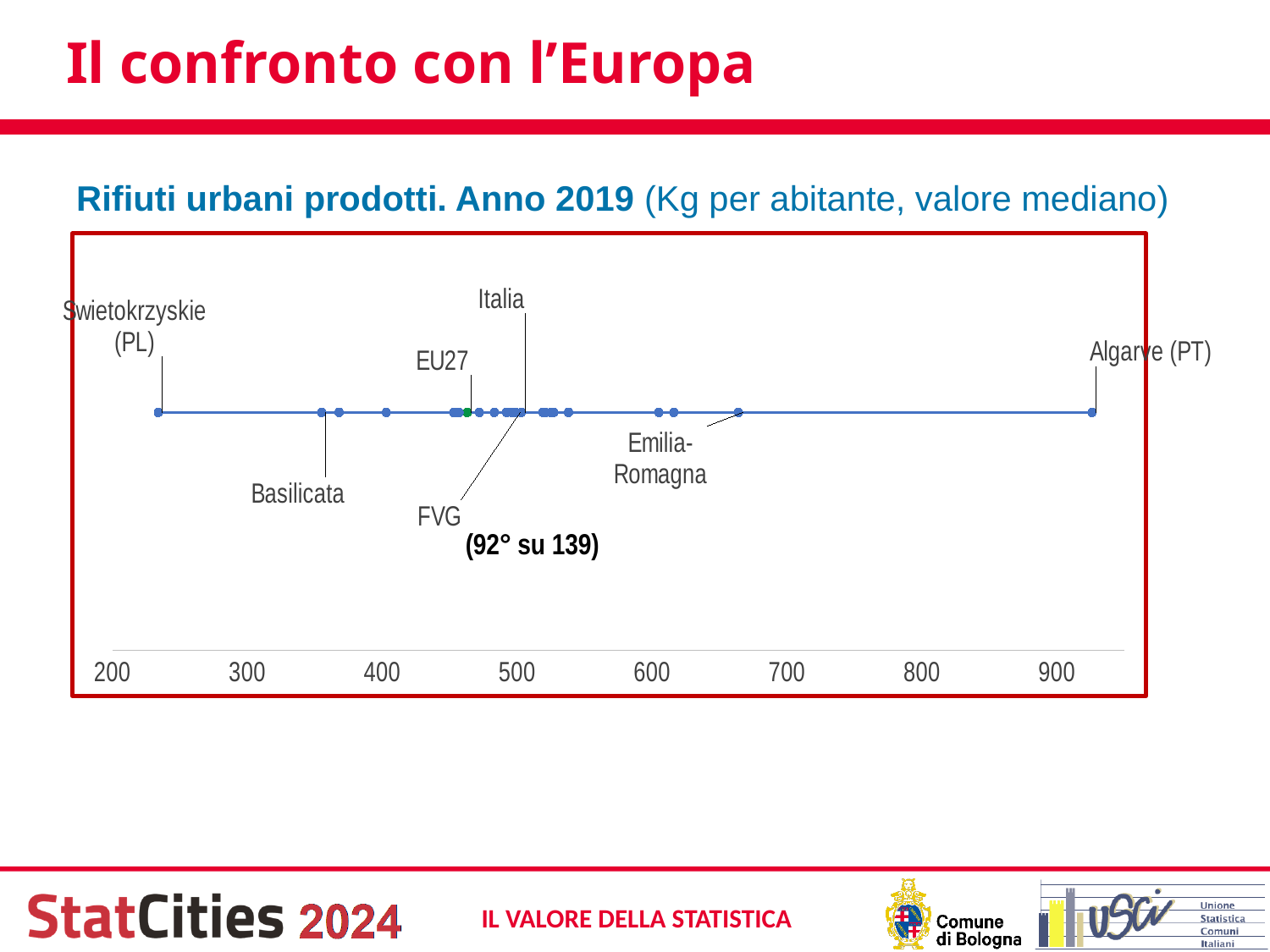
Is the value for Swietokrzyskie (PL) greater or less than 300? less What is the lowest tick value shown on the horizontal axis? 200 Is the value for Algarve (PT) greater or less than 900? greater Is the value for Basilicata greater or less than 400? less Which has a larger value, EU27 or Emilia-Romagna? Emilia-Romagna What rank does the chart annotation give for FVG? 92° su 139 Which labelled region has the lowest value of urban waste produced per inhabitant? Swietokrzyskie (PL) Which has a larger value, Emilia-Romagna or Basilicata? Emilia-Romagna Which labelled region has the highest value of urban waste produced per inhabitant? Algarve (PT) What is the title of the chart? Rifiuti urbani prodotti. Anno 2019 (Kg per abitante, valore mediano)